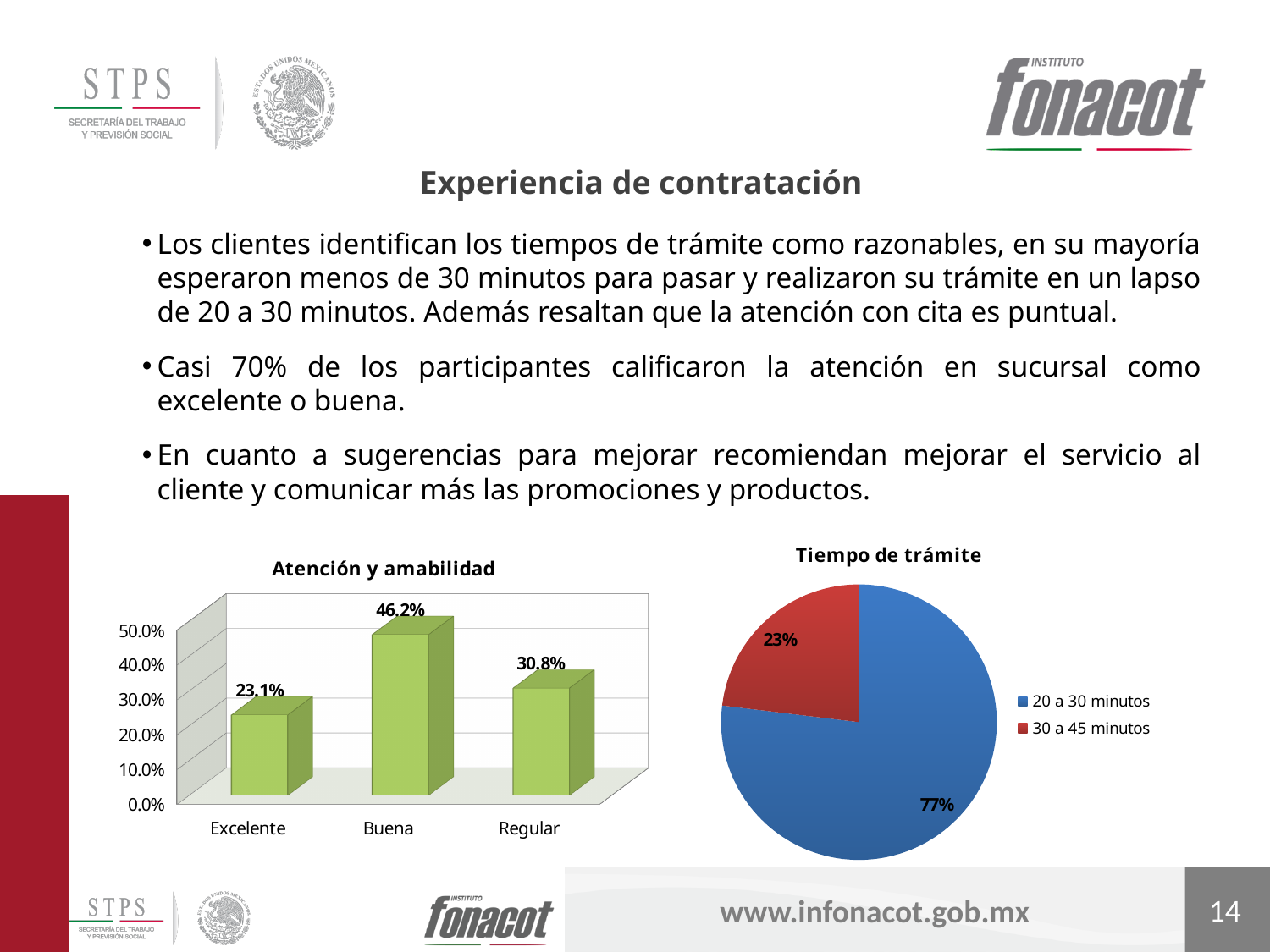
What kind of chart is 'Tiempo de trámite'? Pie chart What kind of chart is 'Atención y amabilidad'? Bar chart In the 'Tiempo de trámite' chart, what share corresponds to '20 a 30 minutos'? 77% In the 'Atención y amabilidad' chart, which category has the highest value? Buena In the 'Atención y amabilidad' chart, what is the difference between Buena and Regular? 15.4% In the 'Tiempo de trámite' chart, what is the value for '30 a 45 minutos'? 23% In the 'Atención y amabilidad' chart, what is the value for Buena? 46.2% In the 'Atención y amabilidad' chart, which category has the lowest value? Excelente In the 'Atención y amabilidad' chart, which is larger, Regular or Excelente? Regular In the 'Atención y amabilidad' chart, how many categories are shown? 3 In the 'Atención y amabilidad' chart, what is the value for Excelente? 23.1% How many entries does the legend of the 'Tiempo de trámite' chart list? 2